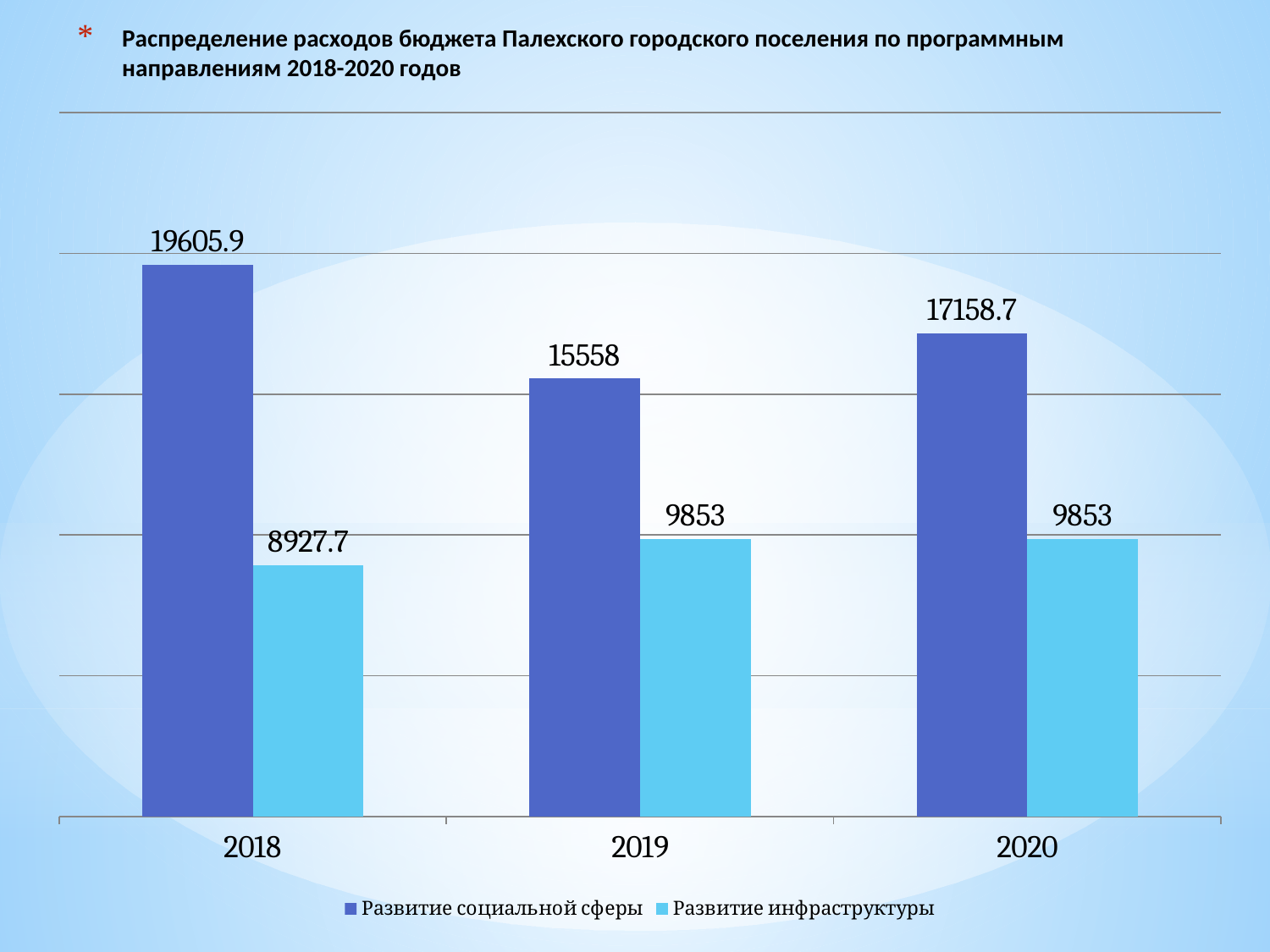
What is the difference between Развитие социальной сферы and Развитие инфраструктуры in 2018? 10678.2 What is the value for Развитие инфраструктуры in 2018? 8927.7 What kind of chart is shown on the slide? Bar chart Which is larger in 2019: Развитие социальной сферы or Развитие инфраструктуры? Развитие социальной сферы What is the value for Развитие социальной сферы in 2020? 17158.7 How many years are shown on the x axis? 3 What is the value for Развитие социальной сферы in 2018? 19605.9 In which year is the value for Развитие социальной сферы the highest? 2018 In which year is the value for Развитие социальной сферы the lowest? 2019 What is the difference between the Развитие социальной сферы values for 2018 and 2020? 2447.2 How many series does the legend list? 2 What is the value for Развитие инфраструктуры in 2019? 9853